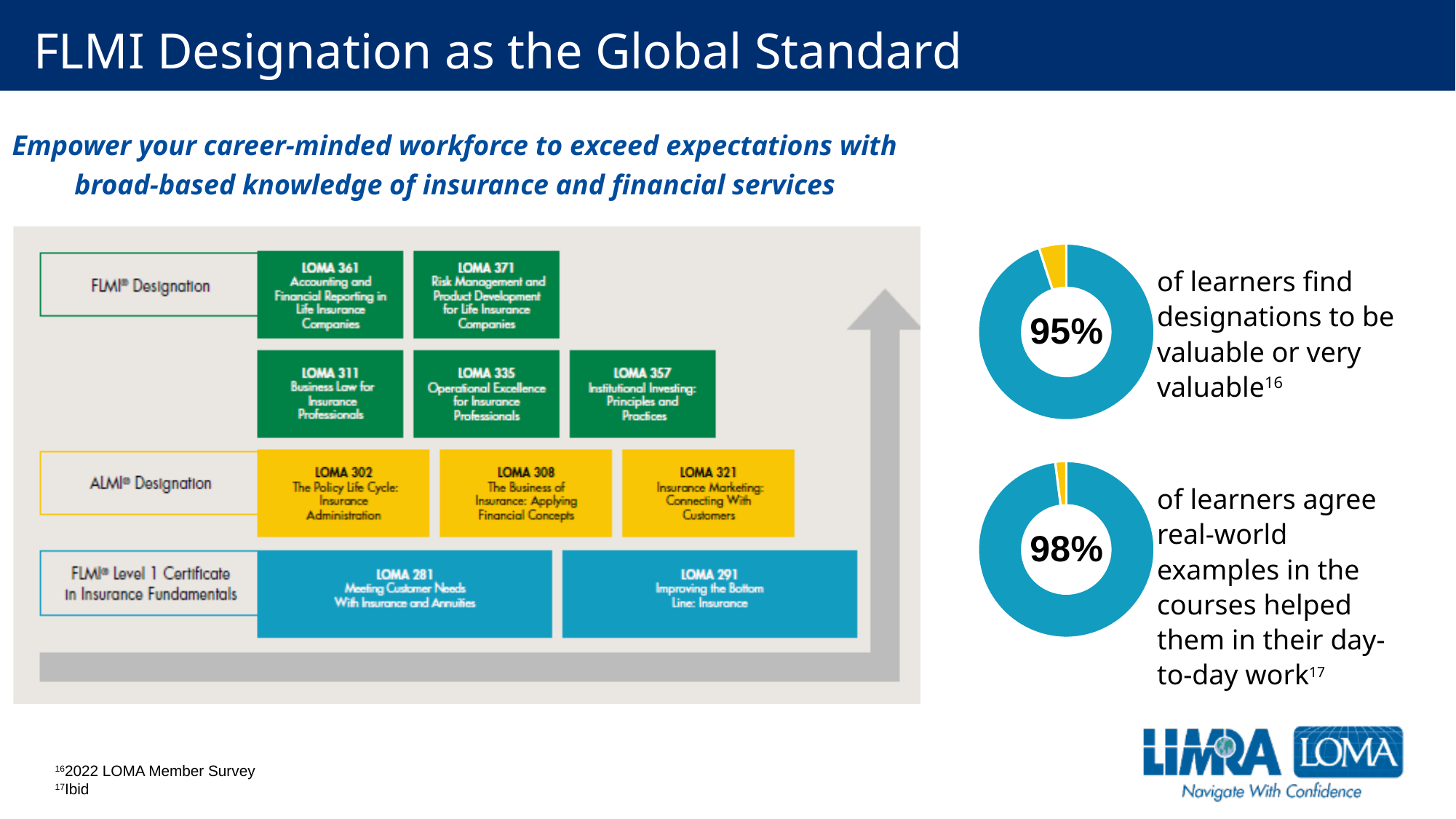
What percentage is shown in the top donut chart on the right of the slide? 95% What colour is the large segment representing the 95% and 98% values in the donut charts? Blue What source is cited in footnote 16 for the 95% statistic in the top donut chart? 2022 LOMA Member Survey Is the value shown in the top donut chart greater or less than 90%? greater How many donut charts are shown on the slide? 2 Which donut chart shows the larger percentage, the top one (designations valuable) or the bottom one (real-world examples helped)? The bottom one (98%) What kind of chart is used to show the 95% statistic on the right of the slide? Donut (pie) chart According to the top donut chart, what share of learners find designations to be valuable or very valuable? 95% How many segments does each donut chart on the slide have? 2 What is the difference in percentage points between the bottom donut chart (98%) and the top donut chart (95%)? 3 percentage points According to the bottom donut chart, what share of learners agree real-world examples in the courses helped them in their day-to-day work? 98% What percentage is shown in the bottom donut chart on the right of the slide? 98%